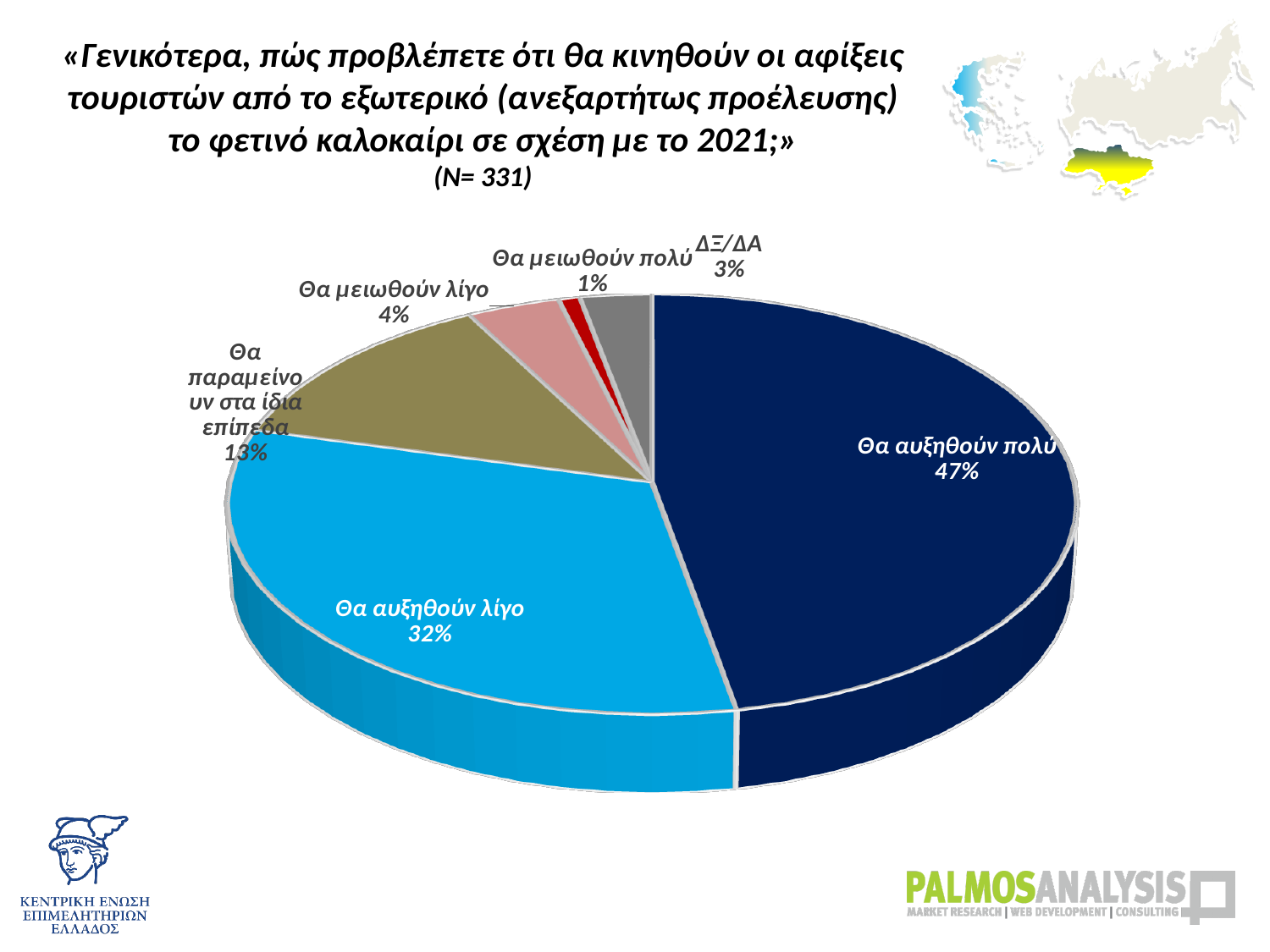
What percentage of respondents answered "ΔΞ/ΔΑ"? 3% What percentage of respondents answered "Θα αυξηθούν λίγο"? 32% Which response has the smallest share of the pie? Θα μειωθούν πολύ What percentage of respondents answered "Θα αυξηθούν πολύ"? 47% What percentage of respondents answered "Θα μειωθούν λίγο"? 4% What kind of chart is shown on the slide? Pie chart What is the difference in percentage points between "Θα αυξηθούν πολύ" and "Θα αυξηθούν λίγο"? 15 percentage points Which is larger: the share for "Θα μειωθούν λίγο" or the share for "ΔΞ/ΔΑ"? Θα μειωθούν λίγο What is the sample size (N) stated under the chart title? 331 How many slices does the pie chart have? 6 What percentage of respondents answered "Θα παραμείνουν στα ίδια επίπεδα"? 13% Which response has the largest share of the pie? Θα αυξηθούν πολύ